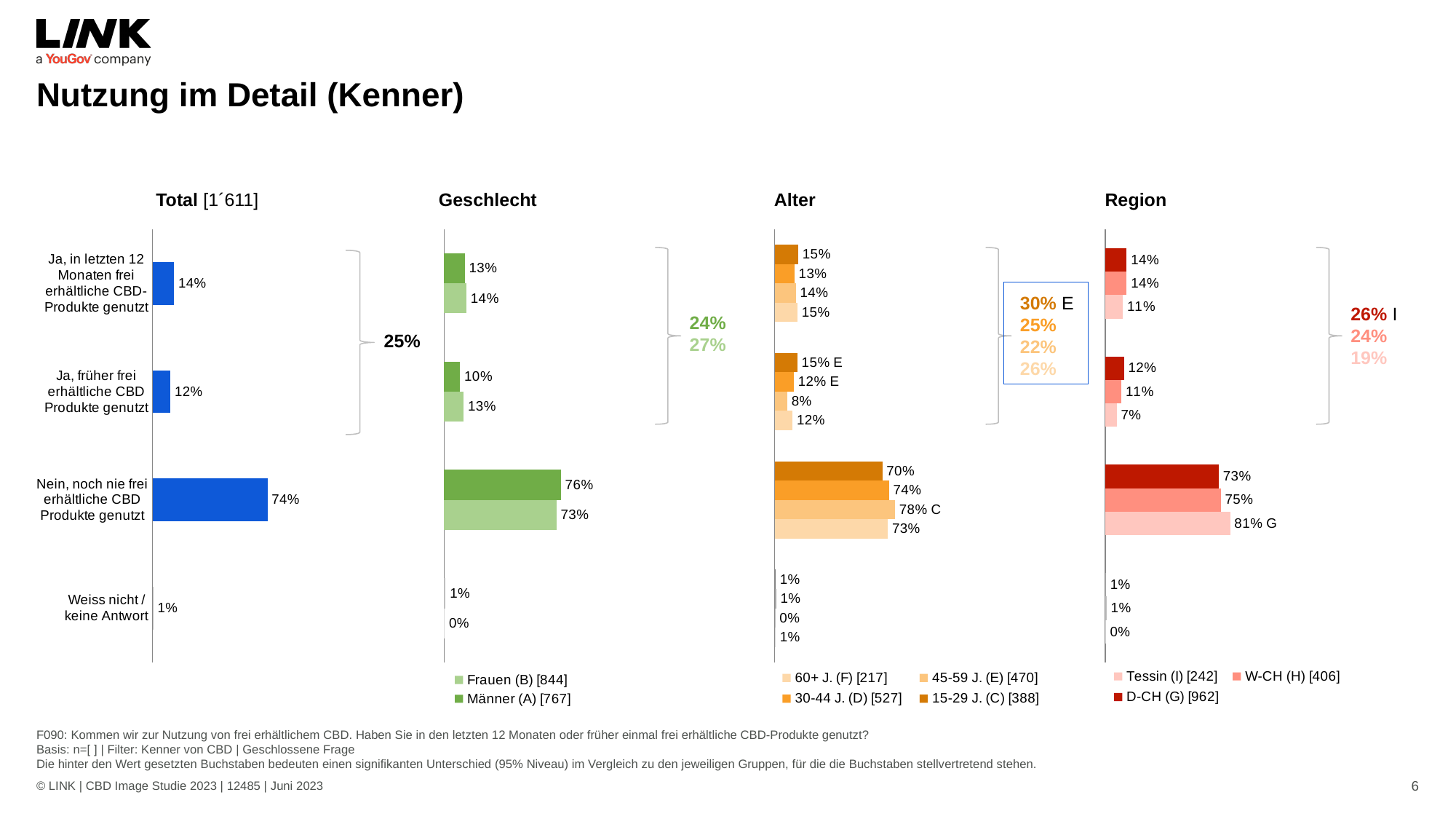
How many series does the legend of the Geschlecht chart list? 2 In the Alter chart, what is the value for 45-59 J. (E) for "Ja, früher frei erhältliche CBD Produkte genutzt"? 8% In the Total chart, what is the value for "Nein, noch nie frei erhältliche CBD Produkte genutzt"? 74% In the Geschlecht chart, what is the value for Männer (A) for "Nein, noch nie frei erhältliche CBD Produkte genutzt"? 76% In the Alter chart, which age group has the highest value for "Nein, noch nie frei erhältliche CBD Produkte genutzt"? 45-59 J. (E) In the Total chart, which category has the highest value? Nein, noch nie frei erhältliche CBD Produkte genutzt In the Region chart, which is larger for "Nein, noch nie frei erhältliche CBD Produkte genutzt": D-CH (G) or W-CH (H)? W-CH (H) In the Region chart, which region has the lowest value for "Ja, früher frei erhältliche CBD Produkte genutzt"? Tessin (I) In the Region chart, what is the value for Tessin (I) for "Nein, noch nie frei erhältliche CBD Produkte genutzt"? 81% In the Geschlecht chart, what is the difference between Frauen (B) and Männer (A) for "Ja, früher frei erhältliche CBD Produkte genutzt"? 3 percentage points How many series does the legend of the Alter chart list? 4 In the Total chart, how many categories are shown? 4